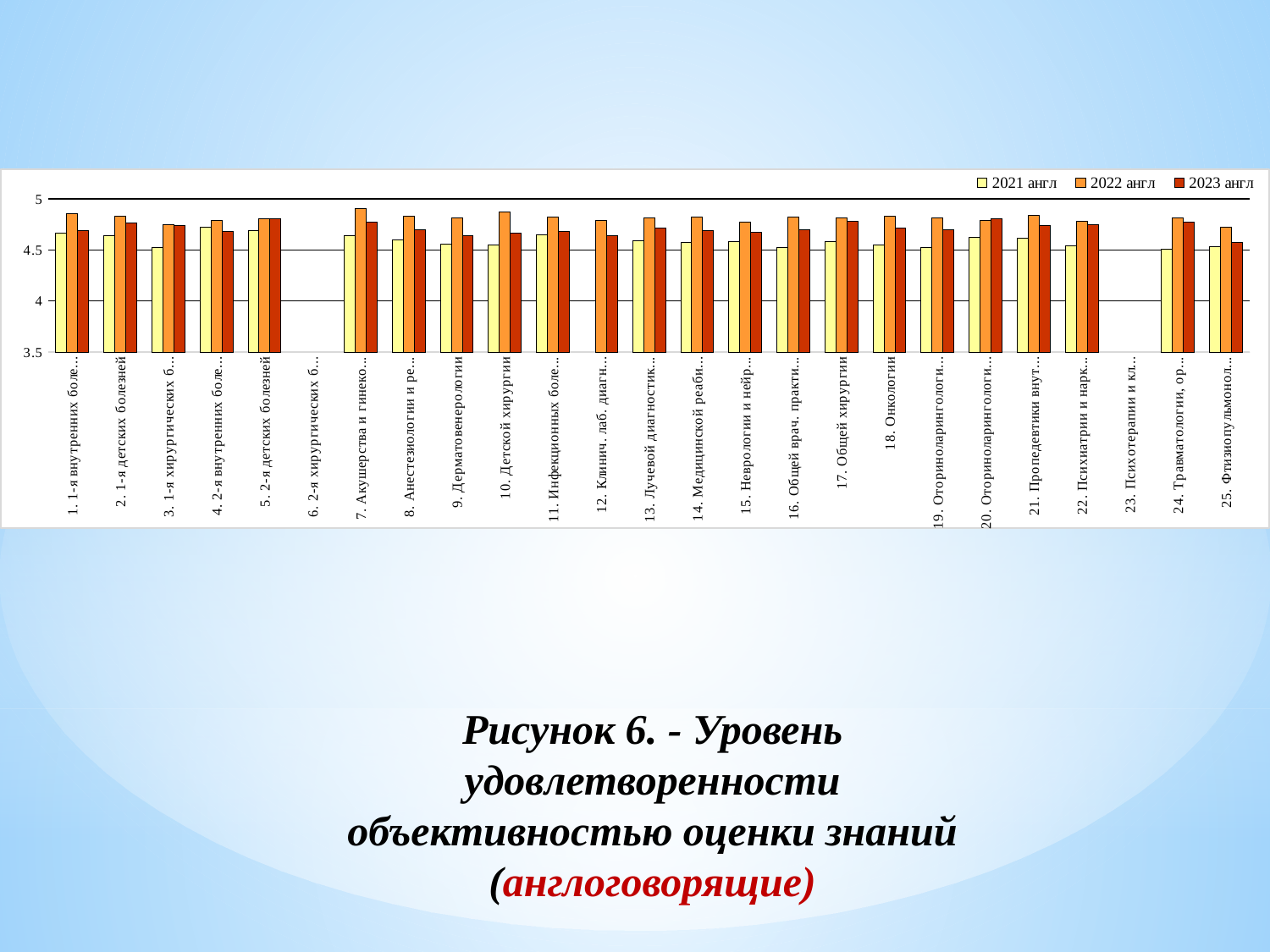
How many series does the legend list? 3 Is the 2021 англ value for 17. Общей хирургии greater or less than 4? greater For 10. Детской хирургии, which is larger: the 2022 англ value or the 2023 англ value? 2022 англ How many numbered categories are shown along the x axis? 25 For 18. Онкологии, which is larger: the 2021 англ value or the 2022 англ value? 2022 англ Is the 2022 англ value for 10. Детской хирургии greater or less than 4.5? greater Which series is drawn in the lightest (pale yellow) colour? 2021 англ For 10. Детской хирургии, which series has the highest value? 2022 англ What are the three series named in the legend? 2021 англ, 2022 англ, 2023 англ What kind of chart is shown on the slide? bar chart For 18. Онкологии, which series has the lowest value? 2021 англ Is the 2023 англ value for 18. Онкологии greater or less than 4.5? greater